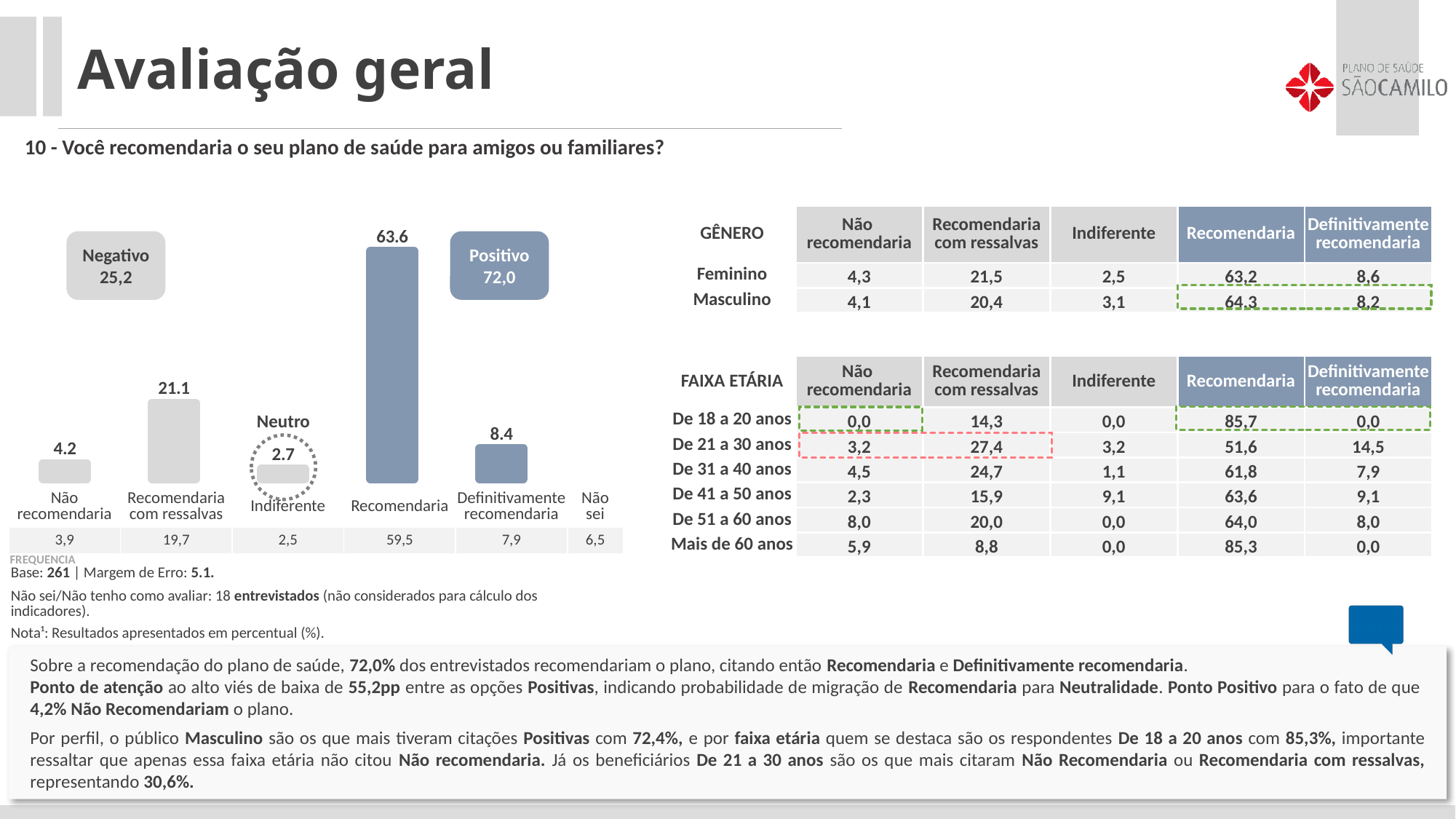
What is the difference between the Recomendaria com ressalvas and Não recomendaria values? 16.9 Which category has the highest bar in the chart? Recomendaria What is the difference between the Recomendaria and Definitivamente recomendaria values in the chart? 55.2 What is the value shown for Recomendaria com ressalvas in the chart? 21.1 Which is larger in the chart, Não recomendaria or Definitivamente recomendaria? Definitivamente recomendaria What kind of chart is shown on the left of the slide? bar chart What value is shown in the Positivo box above the chart? 72,0 What value is shown in the Negativo box above the chart? 25,2 Which category has the lowest value in the chart? Indiferente What is the value of the Recomendaria bar in the chart? 63.6 What is the value of the Definitivamente recomendaria bar? 8.4 What value is shown for Indiferente in the chart? 2.7